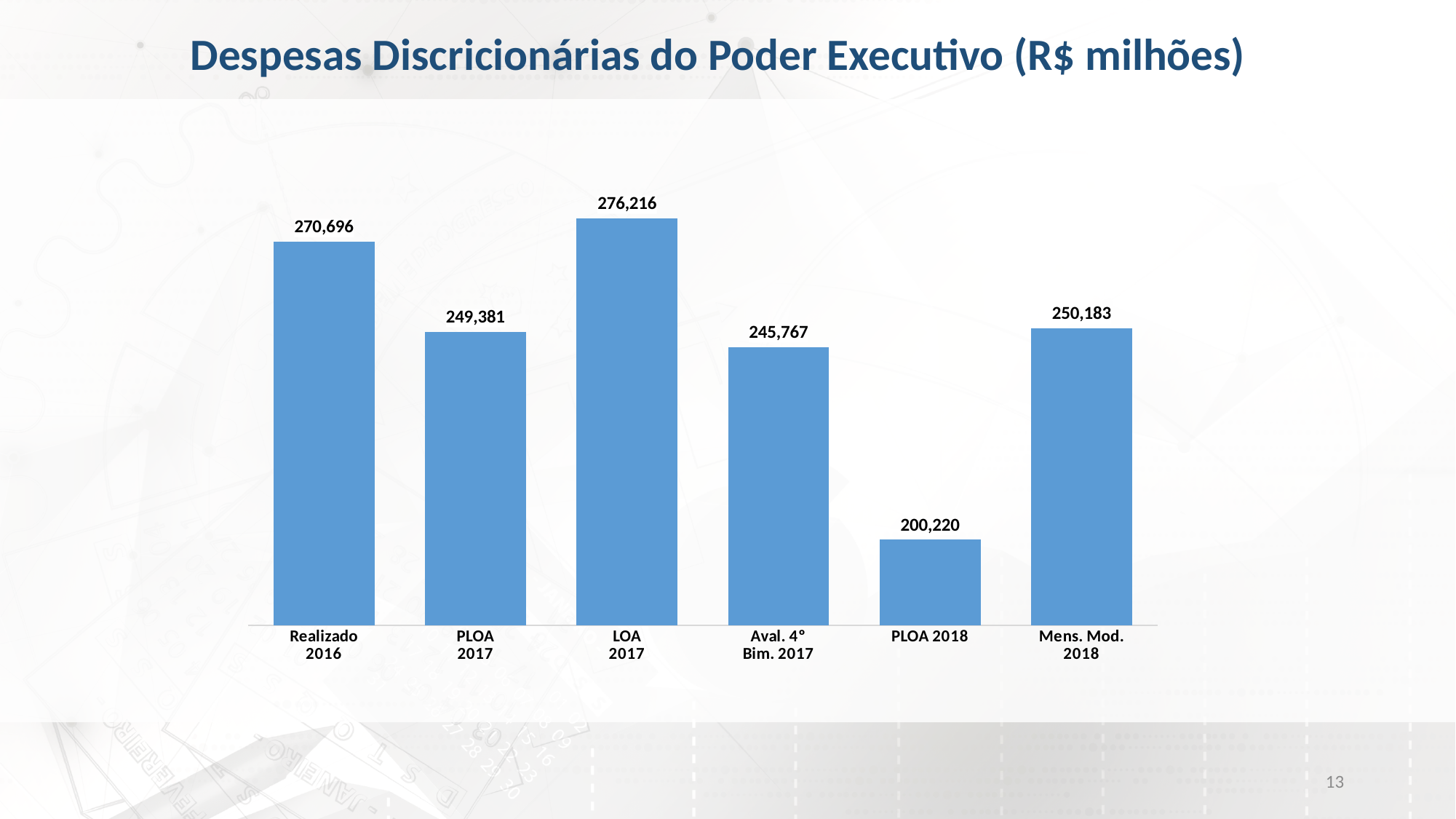
What is the difference between Mens. Mod. 2018 and PLOA 2018? 49,963 Which is larger, Realizado 2016 or Mens. Mod. 2018? Realizado 2016 Which category has the lowest value? PLOA 2018 Which category has the highest value? LOA 2017 How many categories are shown in the chart? 6 What is the title of the chart? Despesas Discricionárias do Poder Executivo (R$ milhões) What is the value for Mens. Mod. 2018? 250,183 What is the difference between LOA 2017 and PLOA 2017? 26,835 What is the value for Aval. 4° Bim. 2017? 245,767 What is the value for LOA 2017? 276,216 What kind of chart is shown on the slide? Bar chart What is the value for PLOA 2018? 200,220